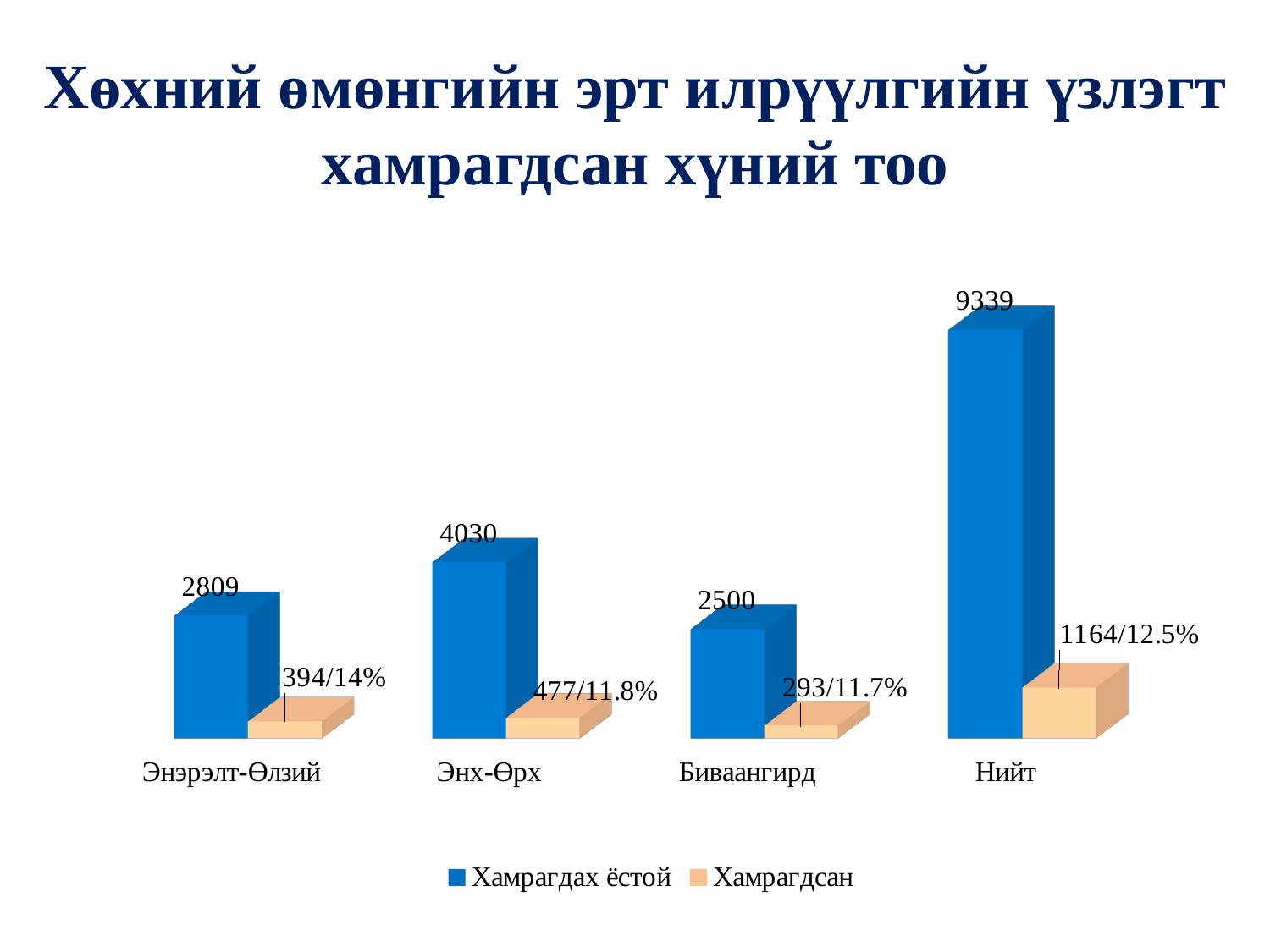
What data label is shown for Хамрагдсан at Энэрэлт-Өлзий? 394/14% Which category has the highest Хамрагдах ёстой value? Нийт What data label is shown for Хамрагдсан at Нийт? 1164/12.5% Among the three districts (excluding Нийт), which has the lowest Хамрагдах ёстой value? Биваангирд What is the value of Хамрагдах ёстой for Биваангирд? 2500 How many categories are shown on the x axis? 4 What is the difference between the Хамрагдах ёстой values for Энх-Өрх and Энэрэлт-Өлзий? 1221 How many series does the legend list? 2 Which series is shown in blue according to the legend? Хамрагдах ёстой Which is larger, the Хамрагдах ёстой value for Энэрэлт-Өлзий or for Биваангирд? Энэрэлт-Өлзий What is the value of Хамрагдах ёстой for Энх-Өрх? 4030 What kind of chart is shown on the slide? Bar chart